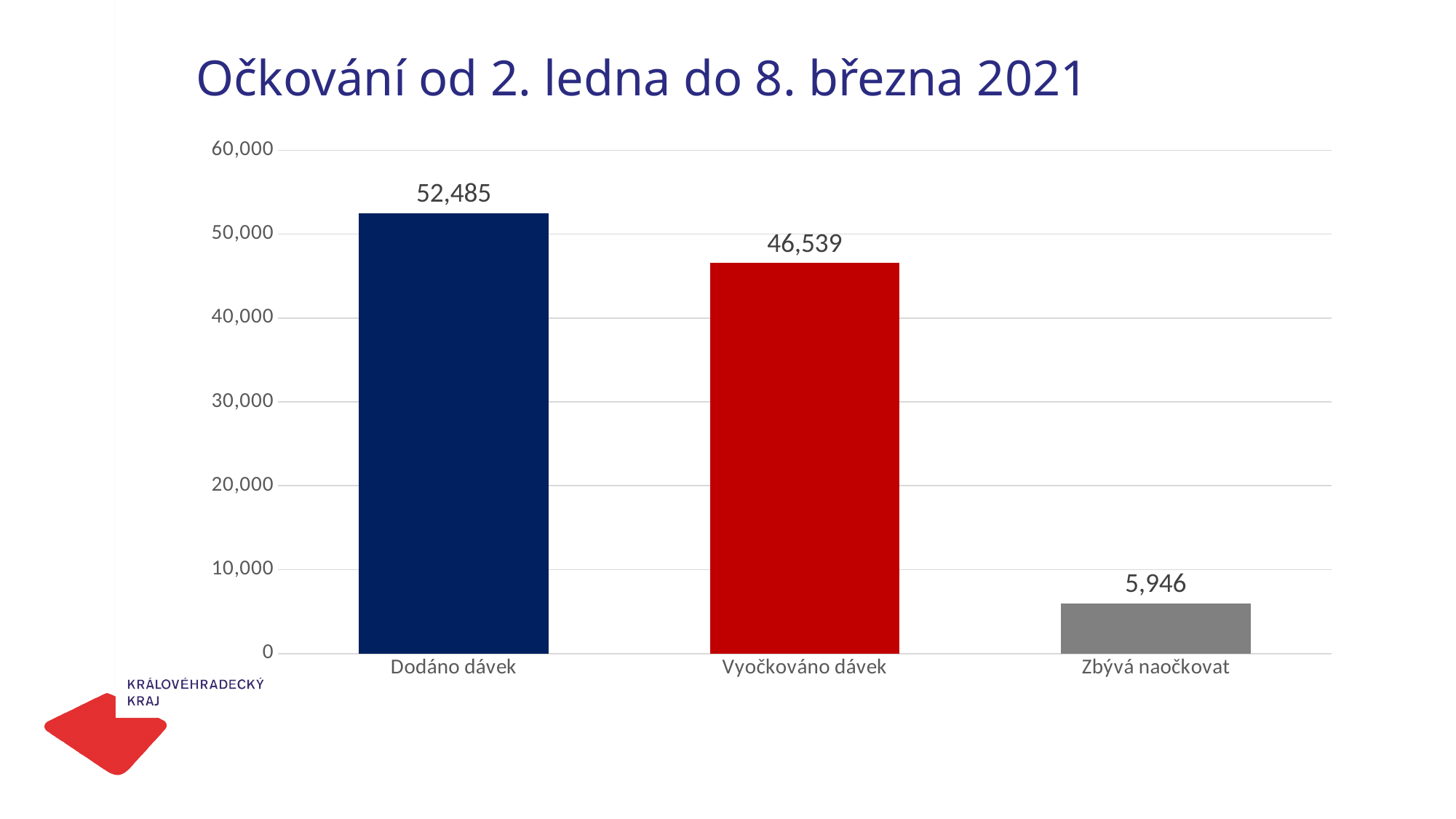
What is the difference between Dodáno dávek and Vyočkováno dávek? 5,946 What kind of chart is shown on the slide? bar chart What is the value for Dodáno dávek? 52,485 Which category has the lowest value? Zbývá naočkovat What is the difference between Vyočkováno dávek and Zbývá naočkovat? 40,593 What is the value for Vyočkováno dávek? 46,539 Is the value for Vyočkováno dávek greater or less than 50,000? less Which category has the highest value? Dodáno dávek How many categories are shown in the chart? 3 What is the value for Zbývá naočkovat? 5,946 Which is larger, Vyočkováno dávek or Zbývá naočkovat? Vyočkováno dávek What is the title of the chart? Očkování od 2. ledna do 8. března 2021